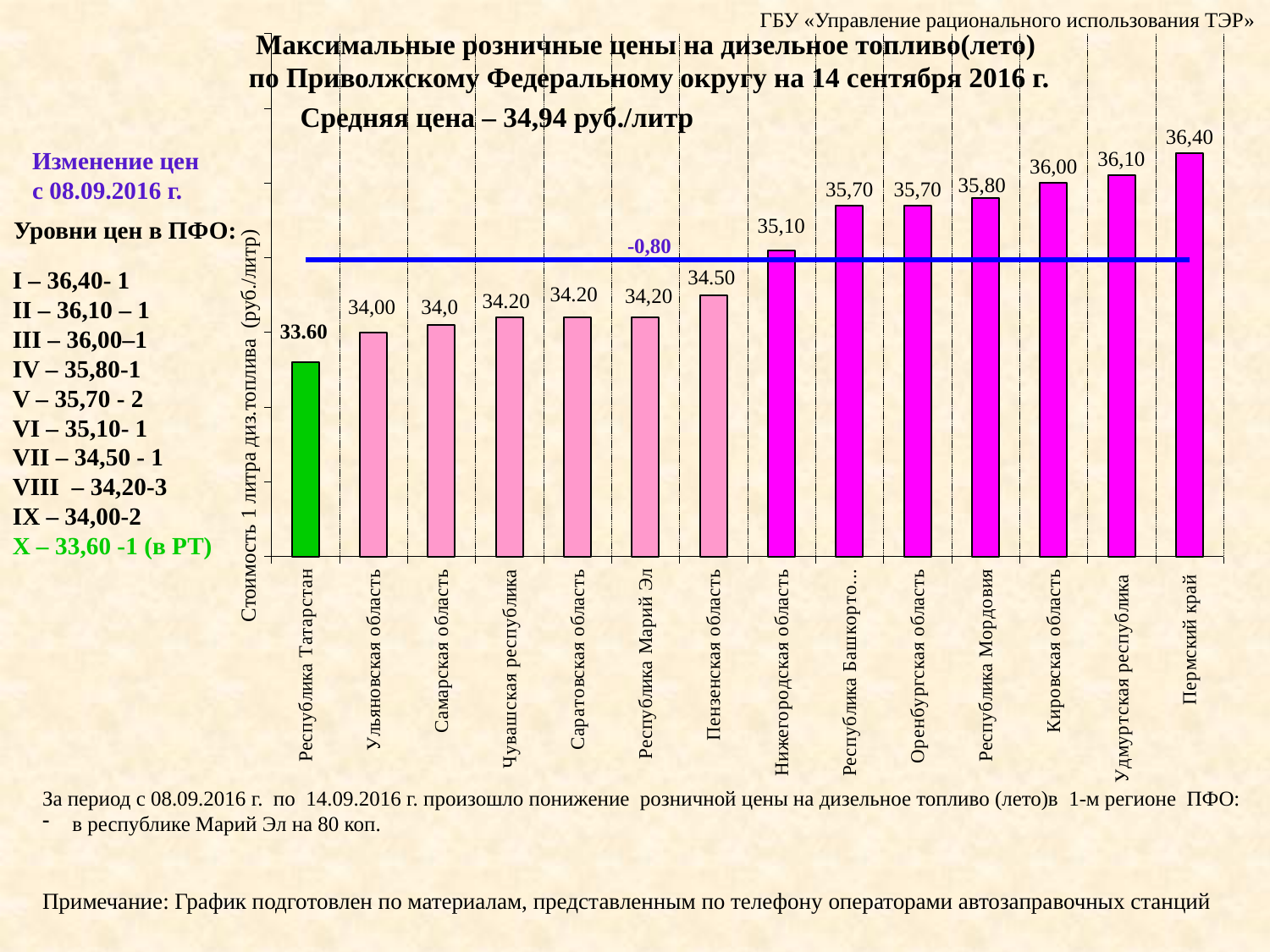
How many regions are shown on the chart? 14 What is the value for Пензенская область? 34.50 Which region has the highest value? Пермский край Which region has the lowest value? Республика Татарстан What kind of chart is shown on the slide? bar chart What is the value for Нижегородская область? 35,10 What is the value for Республика Татарстан? 33.60 What is the difference between the values for Пермский край and Республика Татарстан? 2.80 Do the values rise or fall from left to right along the x axis? rise What is the value for Кировская область? 36,00 What is the value for Пермский край? 36,40 Which is larger, the value for Республика Мордовия or the value for Оренбургская область? Республика Мордовия